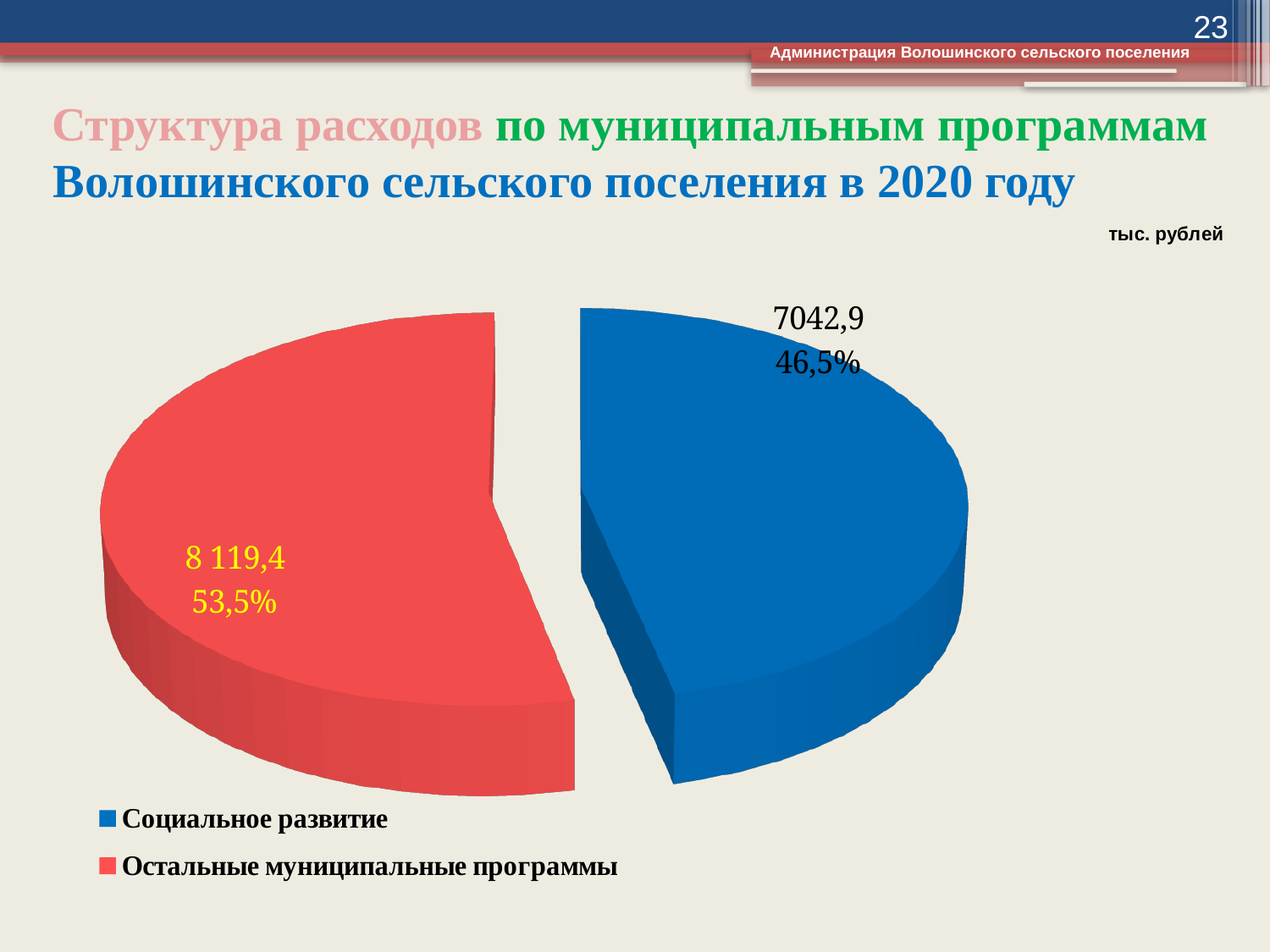
Which category has the largest slice of the pie? Остальные муниципальные программы Which is larger: Социальное развитие or Остальные муниципальные программы? Остальные муниципальные программы What share of the pie does Остальные муниципальные программы take? 53,5% How many slices does the pie chart have? 2 In what units are the values on the chart given? тыс. рублей What is the difference between the values for Остальные муниципальные программы and Социальное развитие? 1 076,5 What share of the pie does Социальное развитие take? 46,5% Which category has the smallest slice of the pie? Социальное развитие What is the value for Остальные муниципальные программы? 8 119,4 What colour is the slice for Социальное развитие? blue What is the value for Социальное развитие? 7042,9 What kind of chart is shown on the slide? pie chart